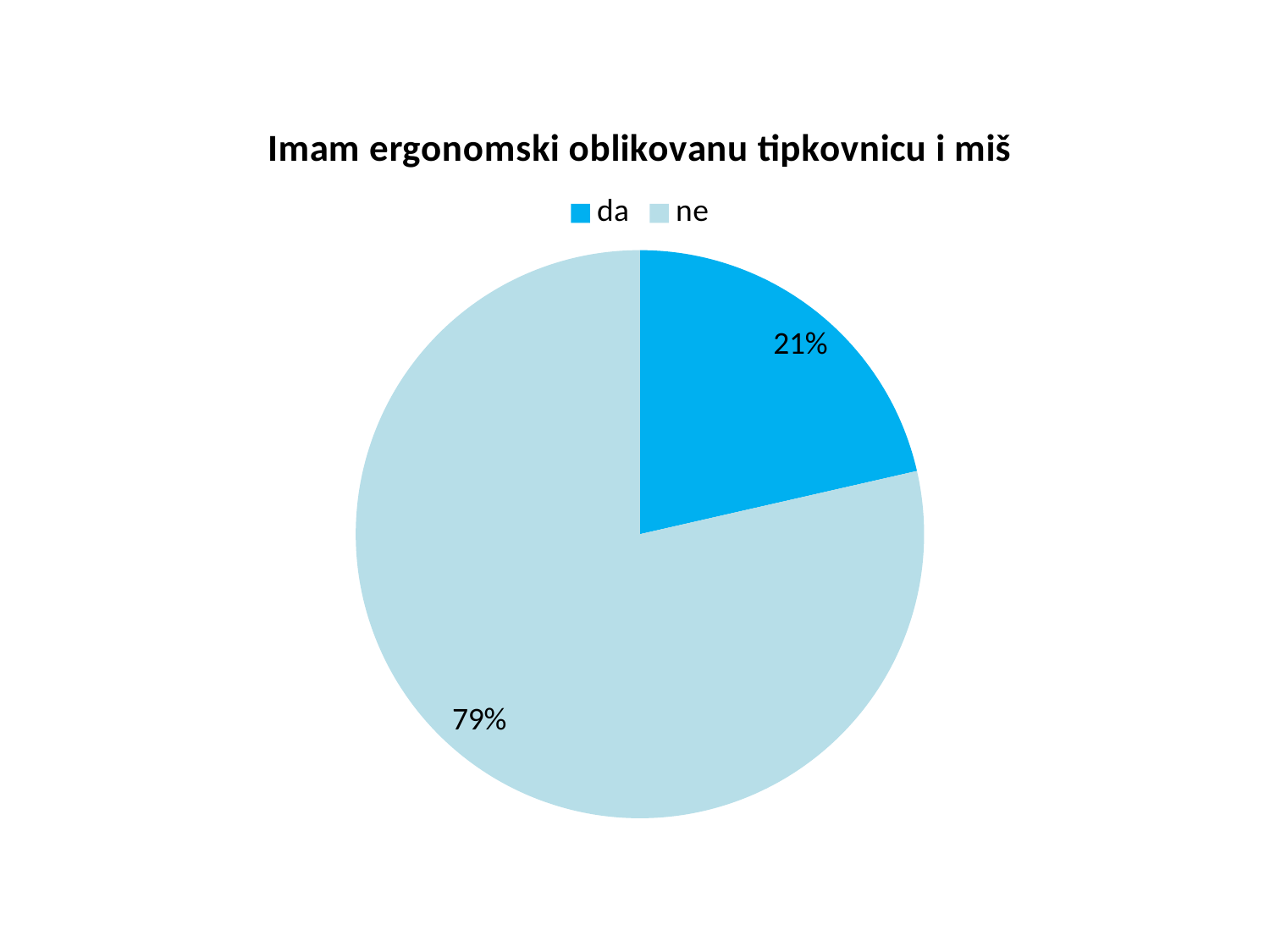
Which slice is the smallest in the pie chart? da Which is larger, the "da" slice or the "ne" slice? ne Which legend entry is shown in the darker blue colour? da What is the difference in percentage points between the "ne" and "da" slices? 58 What share of the pie does the "da" slice represent? 21% What is the title of the chart? Imam ergonomski oblikovanu tipkovnicu i miš Which slice is the largest in the pie chart? ne How many slices does the pie chart have? 2 What kind of chart is shown on the slide? pie chart What share of the pie does the "ne" slice represent? 79% How many entries does the legend list? 2